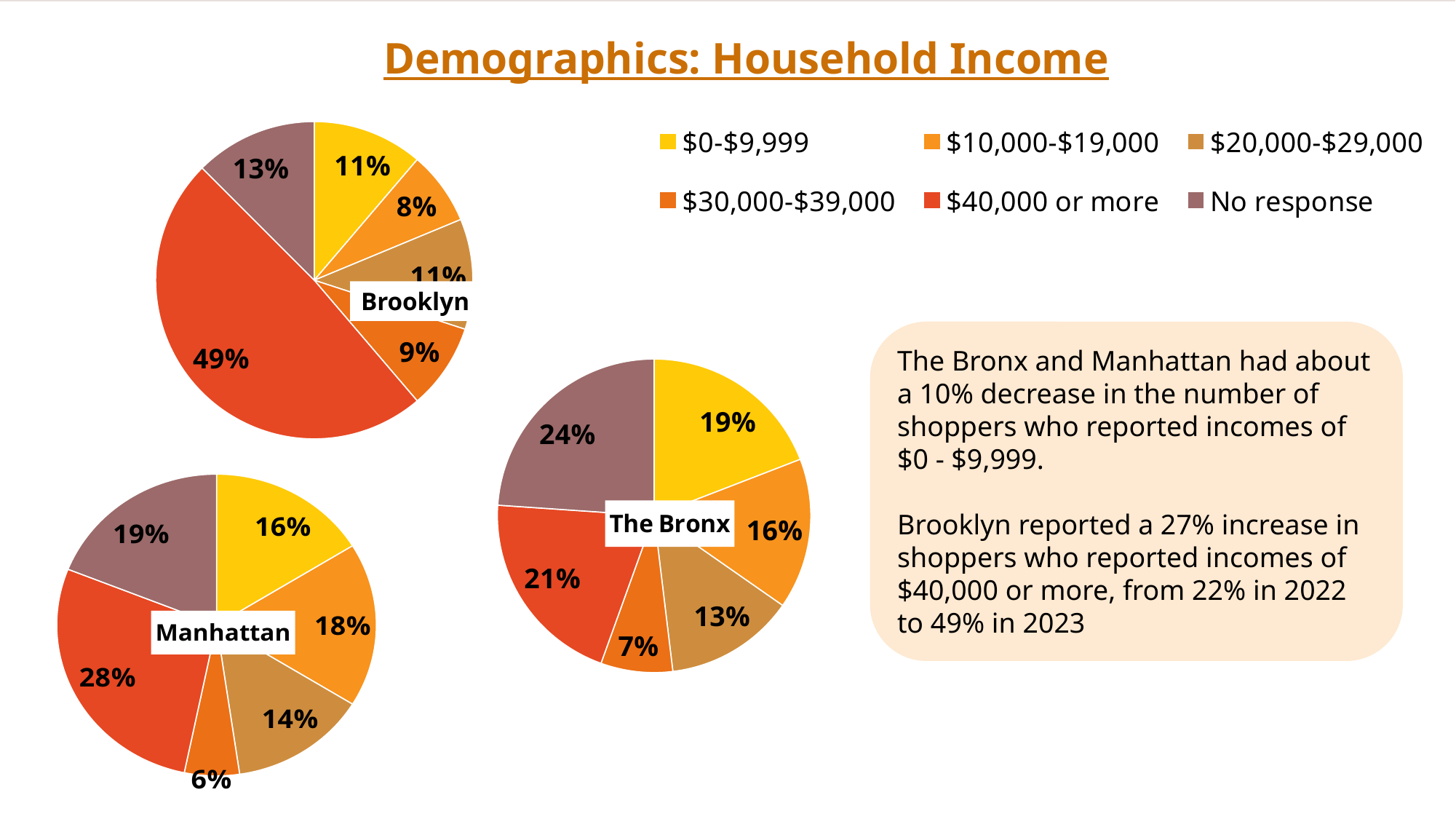
In the Brooklyn pie chart, which income category has the largest slice? $40,000 or more How many categories does the legend list? 6 In the Brooklyn pie chart, what share of shoppers reported incomes of $10,000-$19,000? 8% In the Manhattan pie chart, what share of shoppers reported incomes of $30,000-$39,000? 6% In the Manhattan pie chart, what is the difference between the $40,000 or more slice and the $0-$9,999 slice? 12% In The Bronx pie chart, which is larger: the $40,000 or more slice or the No response slice? No response In The Bronx pie chart, what share of shoppers gave no response? 24% In the Brooklyn pie chart, what share of shoppers reported incomes of $40,000 or more? 49% In the Manhattan pie chart, which income category has the smallest slice? $30,000-$39,000 What kind of charts are shown on the slide? Pie charts In The Bronx pie chart, what share of shoppers reported incomes of $20,000-$29,000? 13% Which borough's pie chart has the largest No response slice? The Bronx